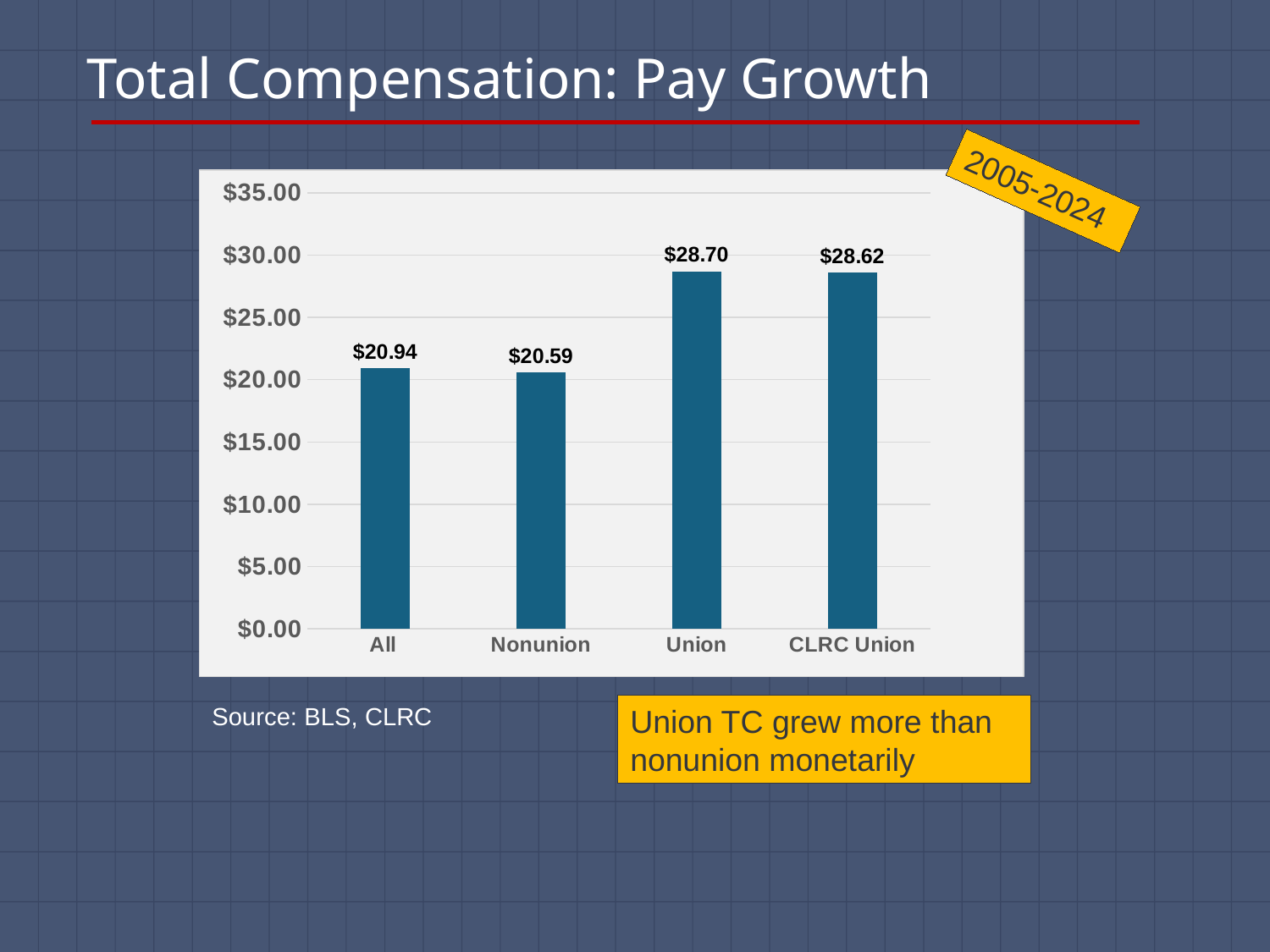
What is the difference between the All and Nonunion values? $0.35 What is the value for All? $20.94 Which is larger, the value for Union or the value for All? Union What is the difference between the Union and Nonunion values? $8.11 Is the value for CLRC Union greater or less than $25.00? greater What kind of chart is shown on the slide? bar chart Which category has the highest value? Union What is the value for Union? $28.70 What is the value for CLRC Union? $28.62 Which category has the lowest value? Nonunion How many categories are shown on the x axis? 4 What is the value for Nonunion? $20.59